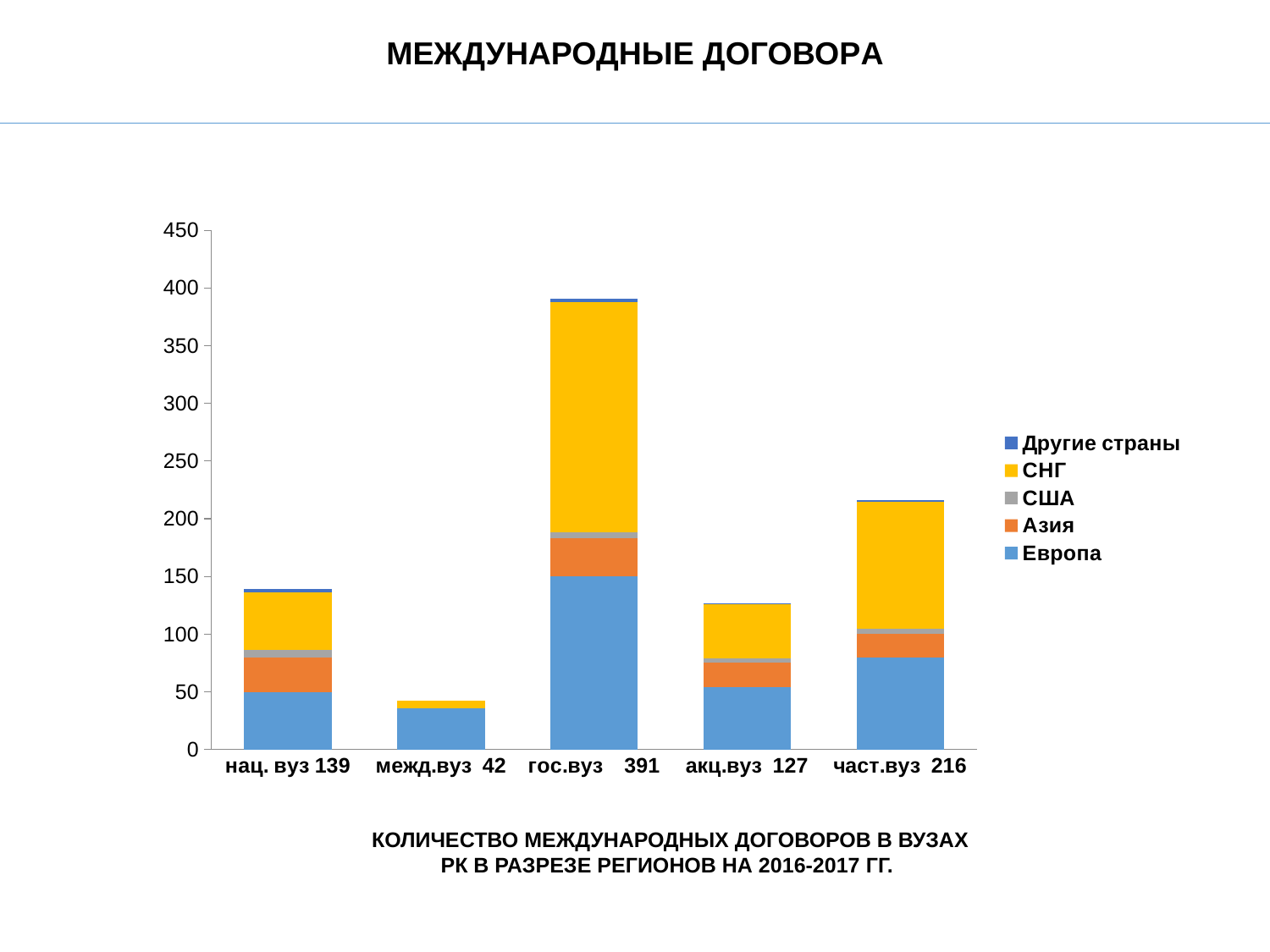
How many series does the legend list? 5 What is the total number of international agreements for гос.вуз? 391 Which category has the highest total number of agreements? гос.вуз What is the difference between the totals for гос.вуз and част.вуз? 175 Which has a larger total, нац. вуз or акц.вуз? нац. вуз Which category has the lowest total number of agreements? межд.вуз Is the Европа value for част.вуз greater or less than 100? less How many categories (bars) are shown on the x axis? 5 What is the total number of international agreements for межд.вуз? 42 What is the total number of international agreements for част.вуз? 216 What kind of chart is shown on the slide? stacked bar chart Which legend entry is shown in yellow? СНГ